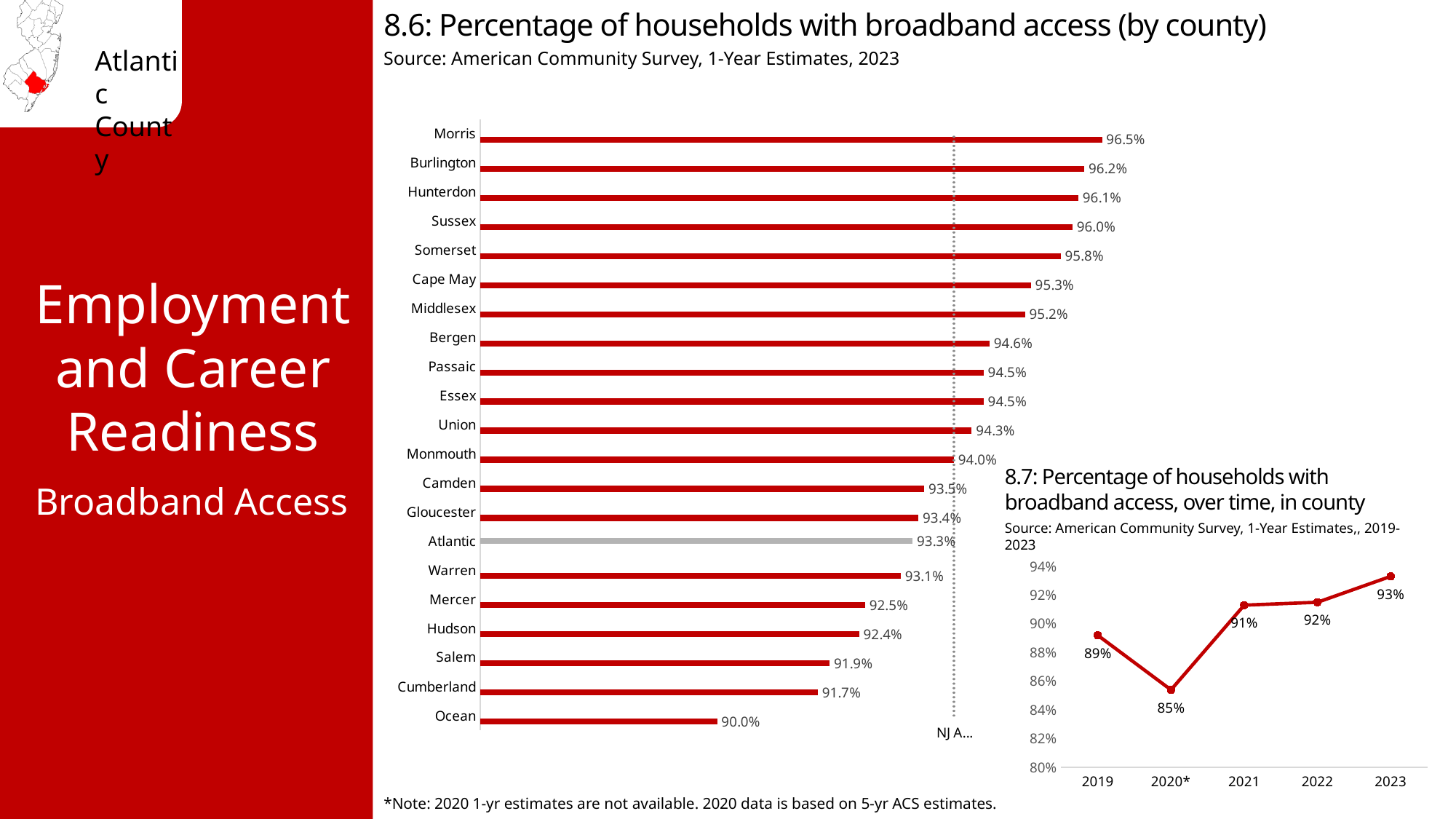
In chart 8.6, what is the difference between the values for Morris and Ocean? 6.5% In chart 8.6, which county has the lowest percentage of households with broadband access? Ocean How many counties are shown in chart 8.6? 21 In chart 8.7, what is the difference between the values for 2023 and 2019? 4% In chart 8.7 (broadband access over time in county), what is the value for 2020*? 85% In chart 8.6, which county has a higher value, Camden or Hudson? Camden What kind of chart is chart 8.6? Bar chart In chart 8.6, which county has the highest percentage of households with broadband access? Morris In chart 8.6, what is the value for Cape May? 95.3% What kind of chart is chart 8.7? Line chart In chart 8.7, which year has the highest percentage of households with broadband access? 2023 In chart 8.6 (percentage of households with broadband access by county), what is the value for Atlantic? 93.3%